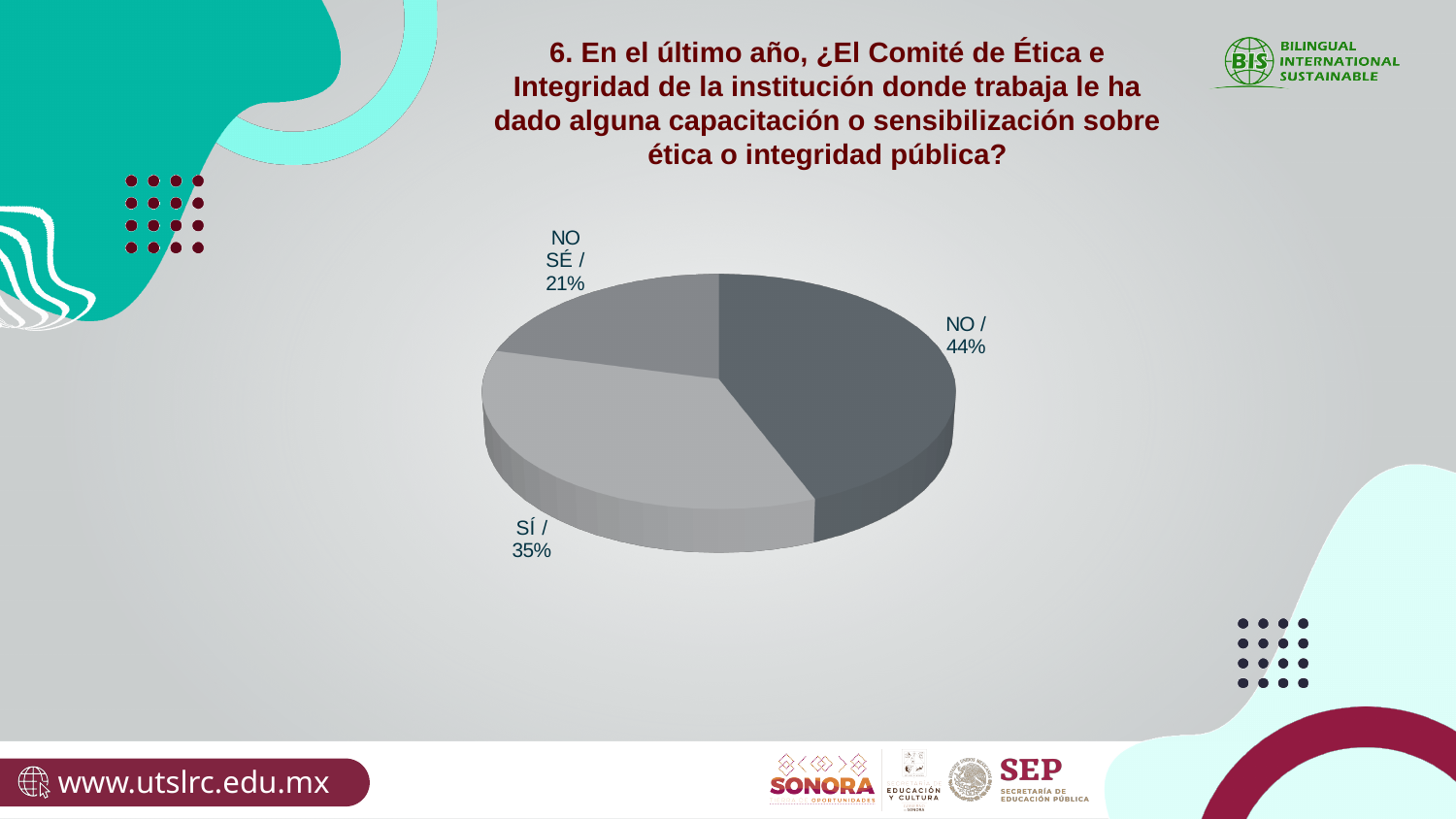
Which response has the largest share of the pie? NO How many slices does the pie chart have? 3 What is the difference in percentage points between the NO and SÍ slices? 9 What is the combined share of the SÍ and NO slices? 79% What kind of chart is shown on the slide? pie chart Is the share for NO greater or less than 50%? less What percentage of respondents answered NO? 44% Which is larger, the share for SÍ or the share for NO SÉ? SÍ Which response has the smallest share of the pie? NO SÉ What is the difference in percentage points between the SÍ and NO SÉ slices? 14 What percentage of respondents answered SÍ? 35% What percentage of respondents answered NO SÉ? 21%